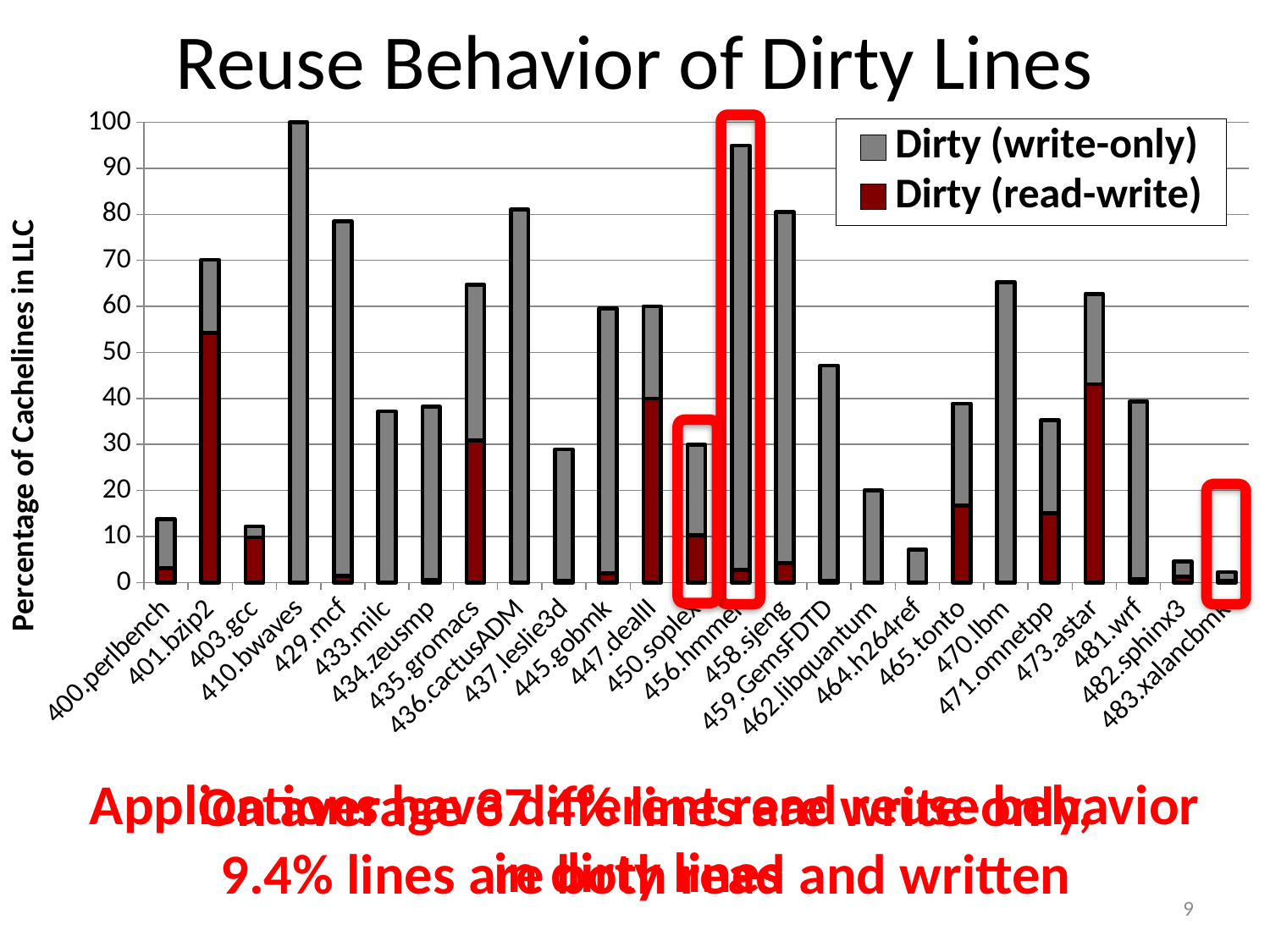
Which colour represents the Dirty (read-write) series in the legend? Dark red What kind of chart is shown on the slide? Stacked bar chart Which benchmark has the largest Dirty (read-write) segment? 401.bzip2 Which has a larger total value, 458.sjeng or 459.GemsFDTD? 458.sjeng Which benchmark has the highest total percentage of dirty cachelines? 410.bwaves How many series does the legend list? 2 Is the total value for 462.libquantum greater or less than 30? less Which benchmark has the lowest total percentage of dirty cachelines? 483.xalancbmk Is the total value for 464.h264ref greater or less than 10? less How many benchmark categories are plotted along the x axis? 25 What is the label of the y axis? Percentage of Cachelines in LLC Is the total value for 456.hmmer greater or less than 90? greater